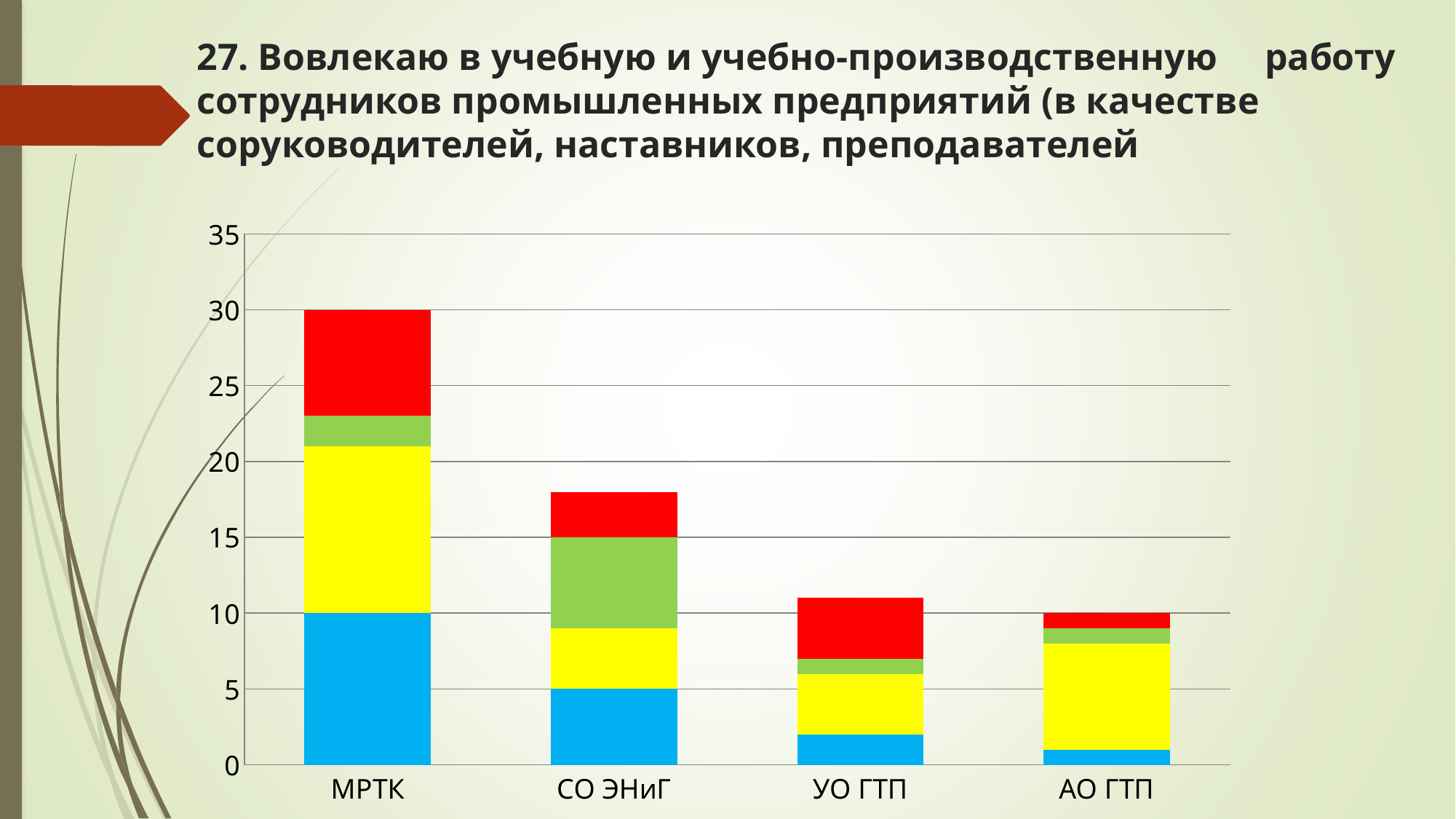
Is the total value for УО ГТП greater or less than 15? less How many coloured segments make up each stacked bar? 4 Do the total bar heights rise or fall from left to right across the categories? fall What is the difference between the total for МРТК and the total for АО ГТП? 20 Which category has the tallest stacked bar? МРТК Which has a larger total, МРТК or СО ЭНиГ? МРТК Is the total value for СО ЭНиГ greater or less than 15? greater Which category has the shortest stacked bar? АО ГТП What kind of chart is shown on the slide? stacked bar chart What is the total height of the stacked bar for МРТК? 30 What is the total height of the stacked bar for АО ГТП? 10 How many categories are shown on the x axis of the chart? 4